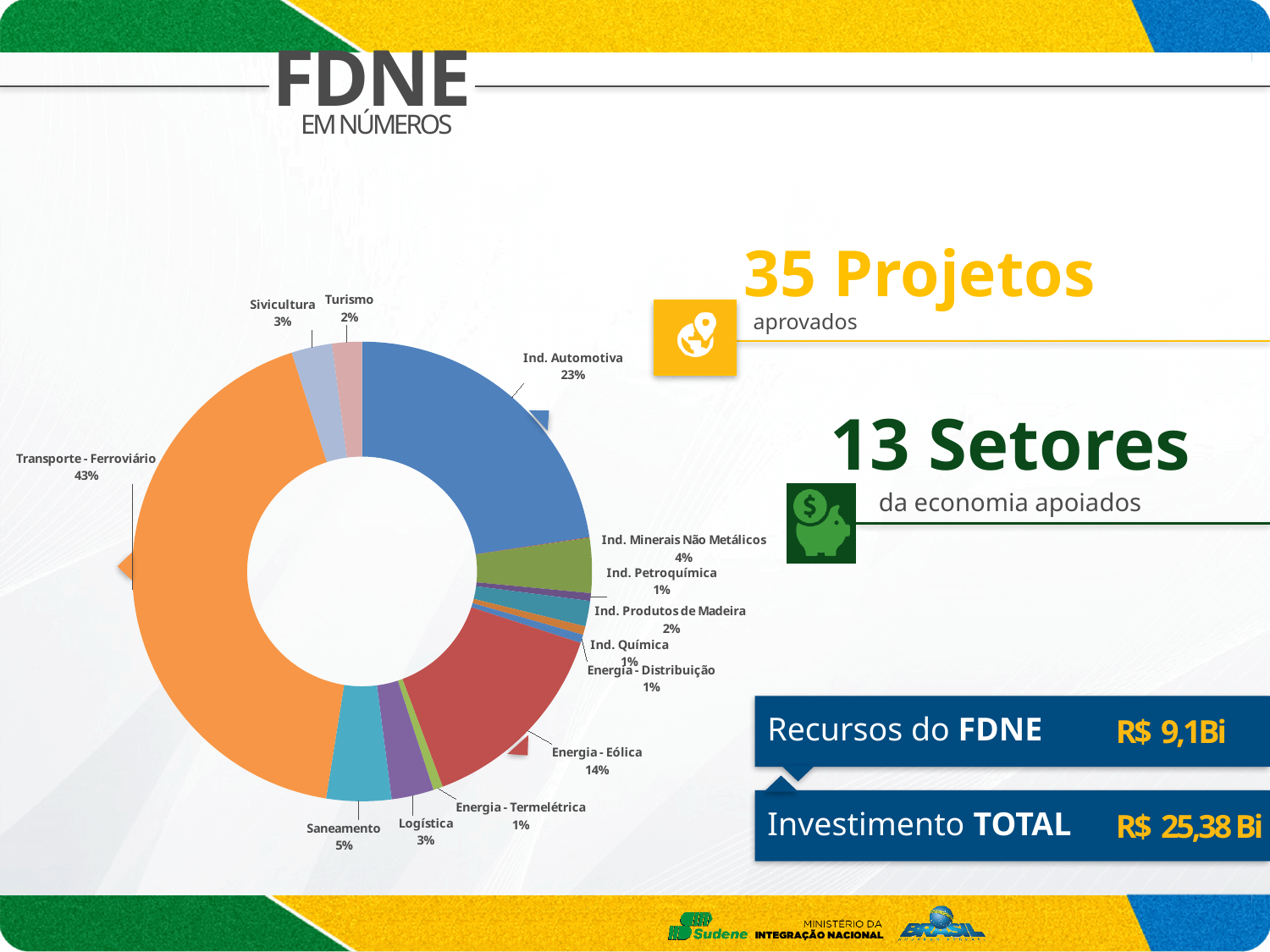
Which has a larger share, Energia - Eólica or Saneamento? Energia - Eólica What kind of chart is shown on the slide? doughnut chart What is the value labelled for Energia - Eólica? 14% Which is larger, Ind. Minerais Não Metálicos or Logística? Ind. Minerais Não Metálicos What percentage is shown for Turismo? 2% How many sectors (slices) are shown in the chart? 13 Which sector has the largest share in the chart? Transporte - Ferroviário What is the difference in percentage points between Transporte - Ferroviário and Ind. Automotiva? 20 What percentage is shown for Ind. Automotiva in the chart? 23% What colour is the Transporte - Ferroviário slice? orange What percentage does Saneamento account for in the chart? 5% What share of the pie chart does Transporte - Ferroviário represent? 43%